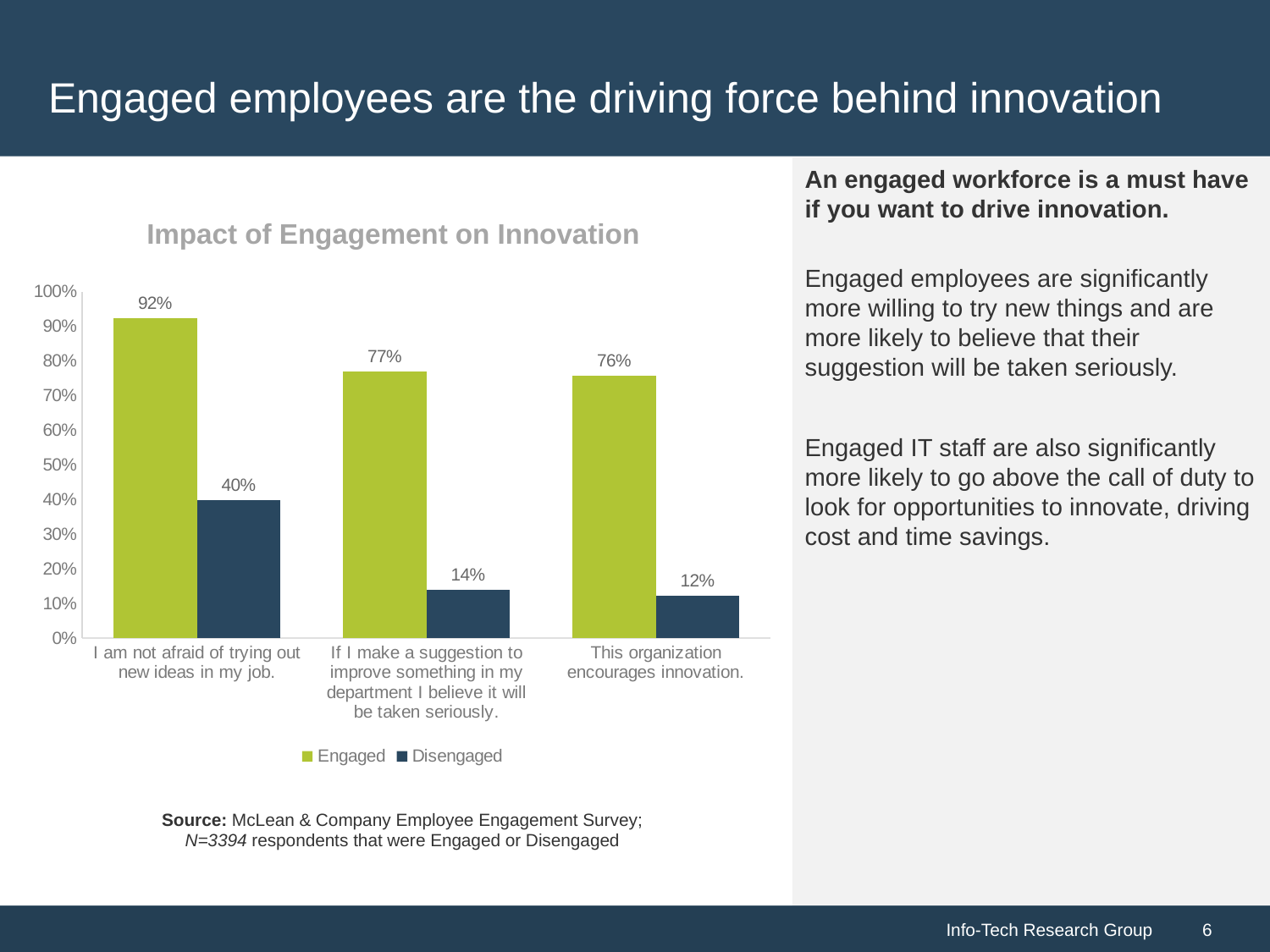
What kind of chart is shown on the slide? Bar chart What is the difference between the Engaged and Disengaged values for "I am not afraid of trying out new ideas in my job."? 52% What is the Disengaged value for "This organization encourages innovation."? 12% What is the Engaged value for "I am not afraid of trying out new ideas in my job."? 92% Which is larger: the Engaged value for "If I make a suggestion to improve something in my department I believe it will be taken seriously." or the Engaged value for "This organization encourages innovation."? If I make a suggestion to improve something in my department I believe it will be taken seriously. What is the title of the chart? Impact of Engagement on Innovation Which category has the lowest Disengaged value? This organization encourages innovation. Which series is shown in green? Engaged Which category has the highest Engaged value? I am not afraid of trying out new ideas in my job. How many categories are shown on the x axis? 3 What is the Disengaged value for "If I make a suggestion to improve something in my department I believe it will be taken seriously."? 14% How many series does the legend list? 2